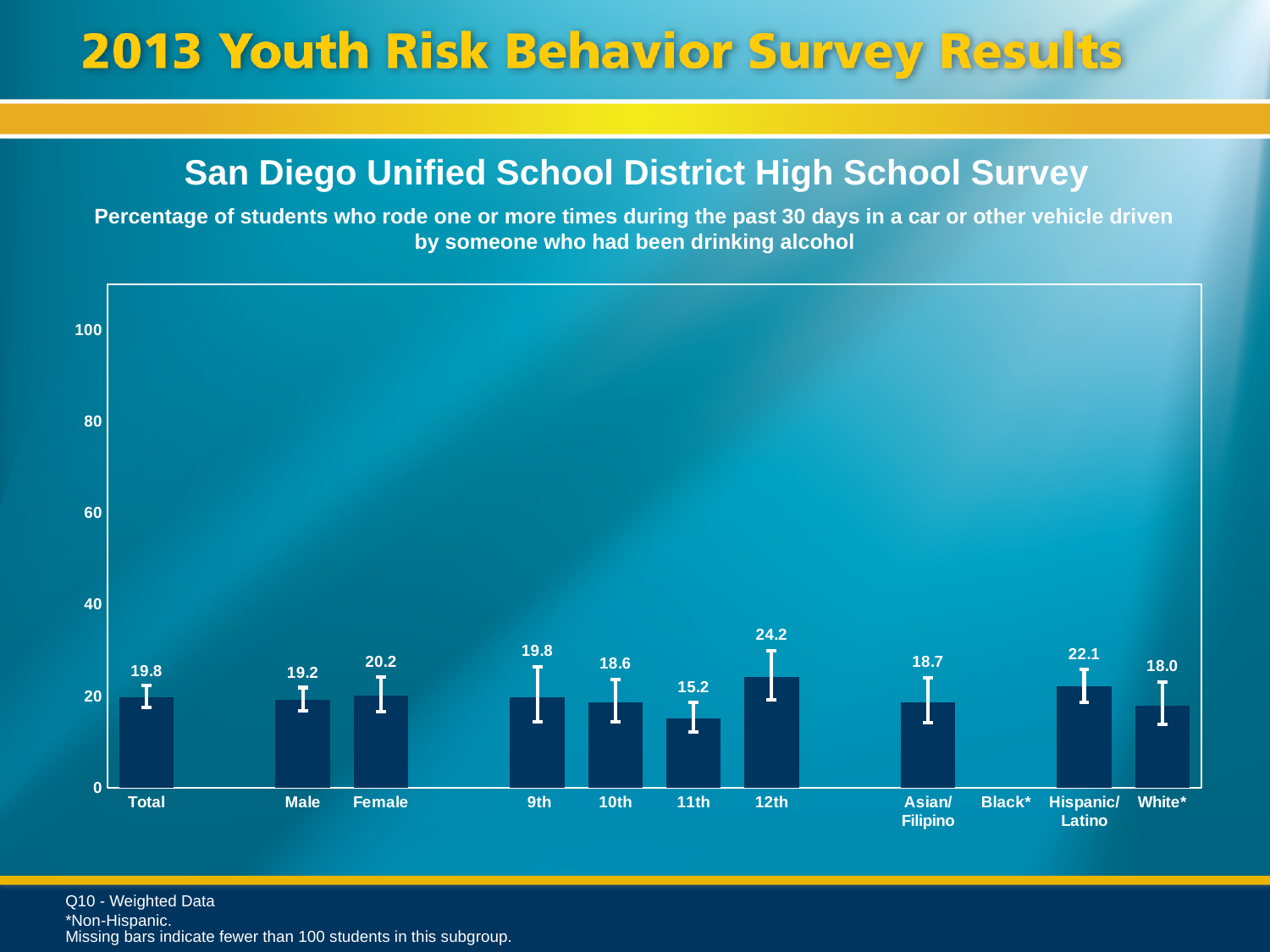
Which is larger, the value for Male or Female students? Female How many categories have a bar plotted? 10 What is the value for Asian/Filipino students? 18.7 Which category has the lowest value among those with bars? 11th Which category has the highest value? 12th What is the value for 12th grade students? 24.2 What is the difference between the values for Hispanic/Latino and White* students? 4.1 Is the value for Hispanic/Latino students greater or less than 20? greater What kind of chart is shown? bar chart Which category label has no bar plotted? Black* What is the difference between the values for 12th and 11th grade students? 9.0 What is the value for Female students? 20.2